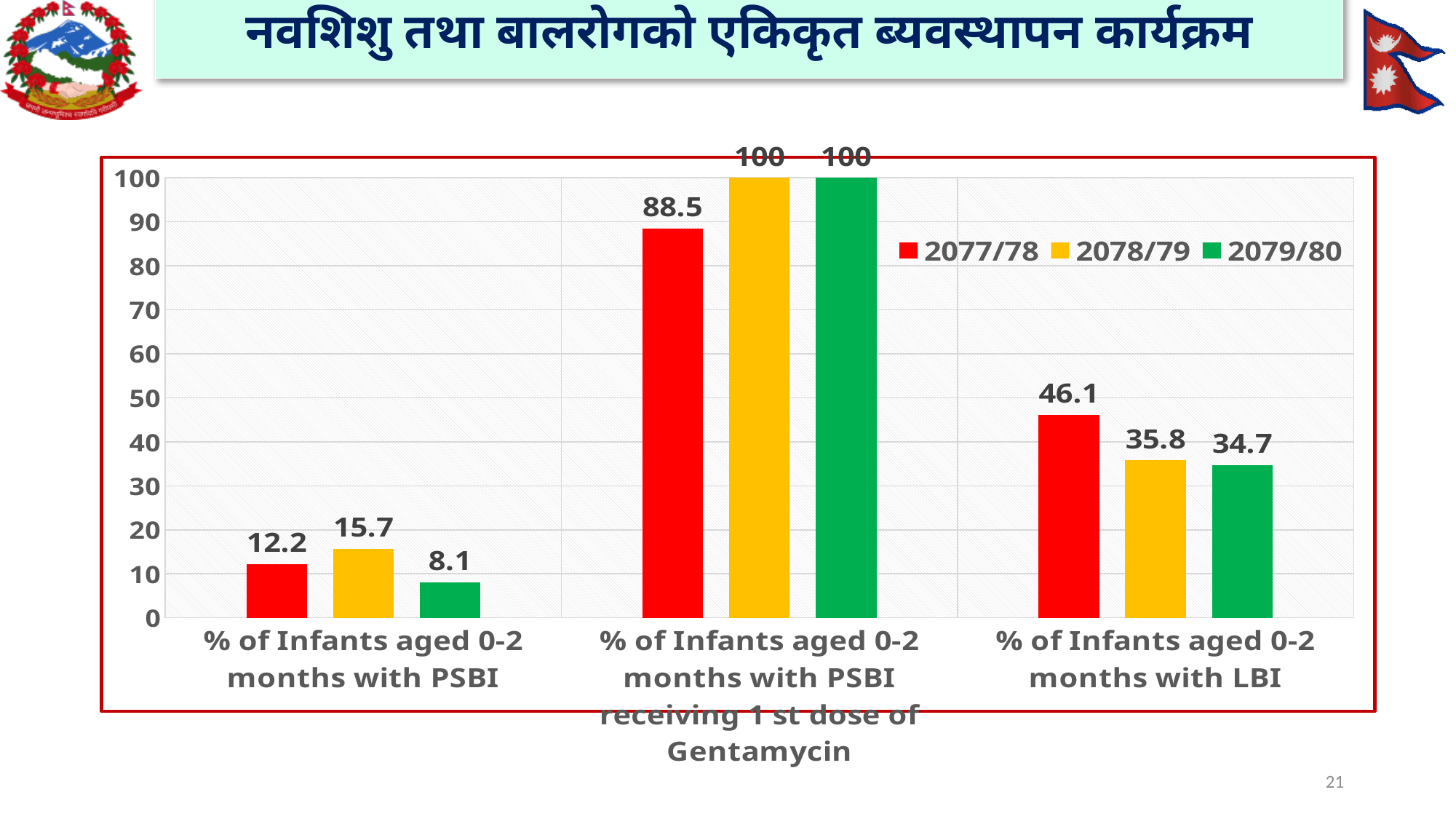
Which year has the lowest value in the category '% of Infants aged 0-2 months with LBI'? 2079/80 What is the difference between the 2077/78 and 2079/80 values in the category '% of Infants aged 0-2 months with LBI'? 11.4 Which colour represents the 2078/79 series in the chart? yellow Which is larger in the category '% of Infants aged 0-2 months with PSBI': the 2077/78 value or the 2079/80 value? 2077/78 What is the value for 2078/79 in the category '% of Infants aged 0-2 months with PSBI receiving 1 st dose of Gentamycin'? 100 Is the 2077/78 value for '% of Infants aged 0-2 months with PSBI receiving 1 st dose of Gentamycin' greater or less than 80? greater How many series does the legend list? 3 What kind of chart is shown on the slide? bar chart How many categories are shown on the x axis of the chart? 3 Which year has the highest value in the category '% of Infants aged 0-2 months with PSBI'? 2078/79 What is the value for 2077/78 in the category '% of Infants aged 0-2 months with PSBI'? 12.2 What is the value for 2079/80 in the category '% of Infants aged 0-2 months with LBI'? 34.7